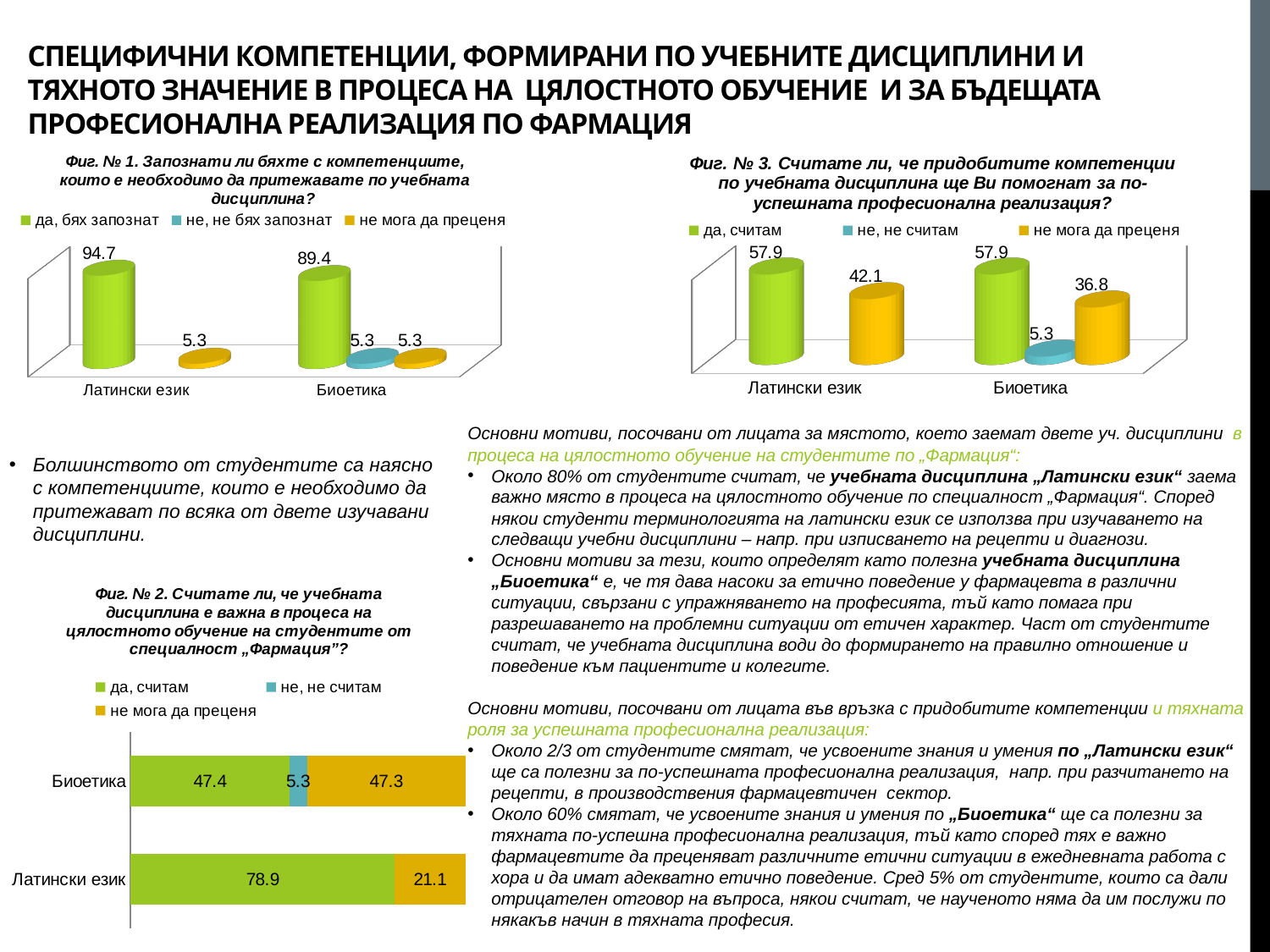
In Фиг. № 3, what is the value for "не, не считам" for Биоетика? 5.3 What kind of chart is Фиг. № 2? Stacked bar chart In Фиг. № 1, what is the difference between the "да, бях запознат" values for Латински език and Биоетика? 5.3 In Фиг. № 1, what is the value for "да, бях запознат" for Биоетика? 89.4 In Фиг. № 3, which is larger: the "не мога да преценя" value for Латински език or for Биоетика? Латински език In Фиг. № 1, what is the value for "да, бях запознат" for Латински език? 94.7 In Фиг. № 1, how many series does the legend list? 3 In Фиг. № 3, what is the value for "не мога да преценя" for Биоетика? 36.8 In Фиг. № 2, what is the total of the stacked bar for Биоетика? 100 In Фиг. № 2, what is the value for "да, считам" for Латински език? 78.9 In Фиг. № 3, what is the value for "не мога да преценя" for Латински език? 42.1 In Фиг. № 2, what is the value for "не мога да преценя" for Биоетика? 47.3